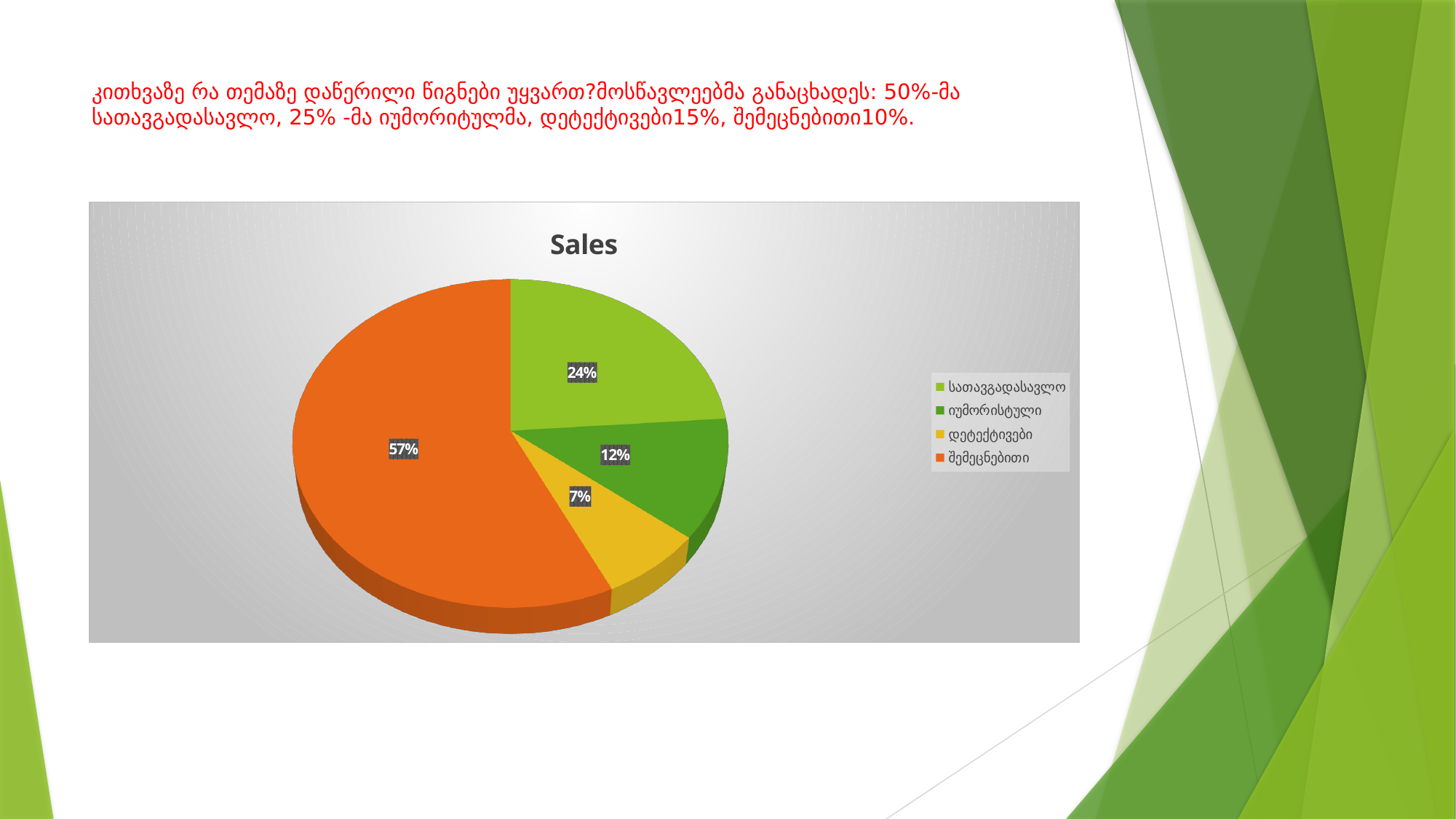
What kind of chart is shown on the slide? pie chart What share of the pie does the სათავგადასავლო slice have? 24% What share of the pie does the შემეცნებითი slice have? 57% What share of the pie does the დეტექტივები slice have? 7% What is the title of the chart? Sales How many slices does the pie chart have? 4 What colour is the შემეცნებითი slice in the pie chart? orange Which category has the smallest slice of the pie? დეტექტივები What is the difference in percentage points between the შემეცნებითი slice and the სათავგადასავლო slice? 33% Which slice is larger, იუმორისტული or დეტექტივები? იუმორისტული Which category has the largest slice of the pie? შემეცნებითი